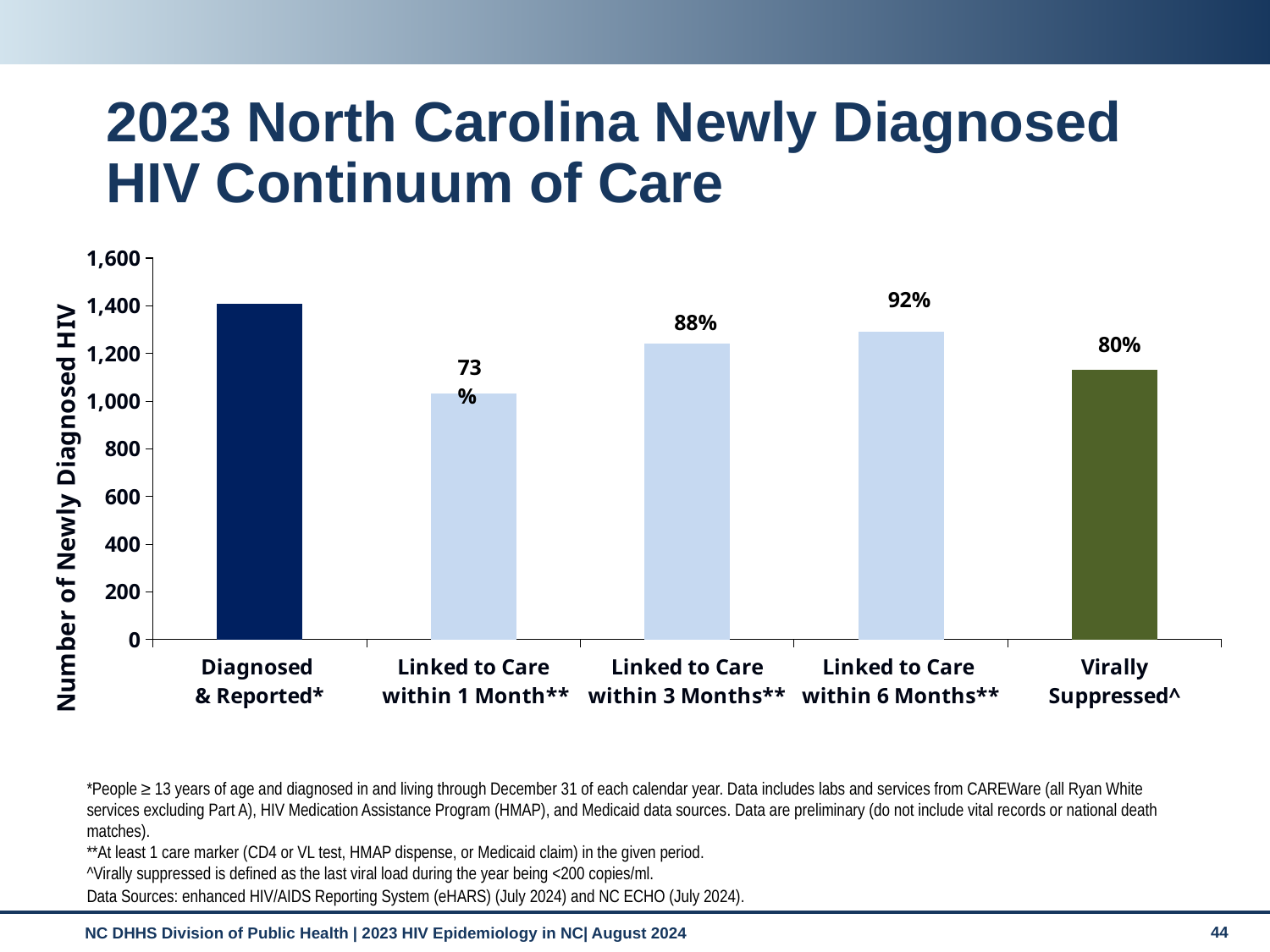
Which category has the shortest bar? Linked to Care within 1 Month** What percentage label is shown above the bar for Linked to Care within 6 Months**? 92% What type of chart is shown on the slide? Bar chart What percentage label is shown above the bar for Linked to Care within 1 Month**? 73% Which bar is taller: Linked to Care within 3 Months** or Virally Suppressed^? Linked to Care within 3 Months** Is the value for Virally Suppressed^ greater or less than 1,200? less What percentage label is shown above the bar for Virally Suppressed^? 80% How many categories are shown on the x axis? 5 Which category has the tallest bar? Diagnosed & Reported* What percentage label is shown above the bar for Linked to Care within 3 Months**? 88%